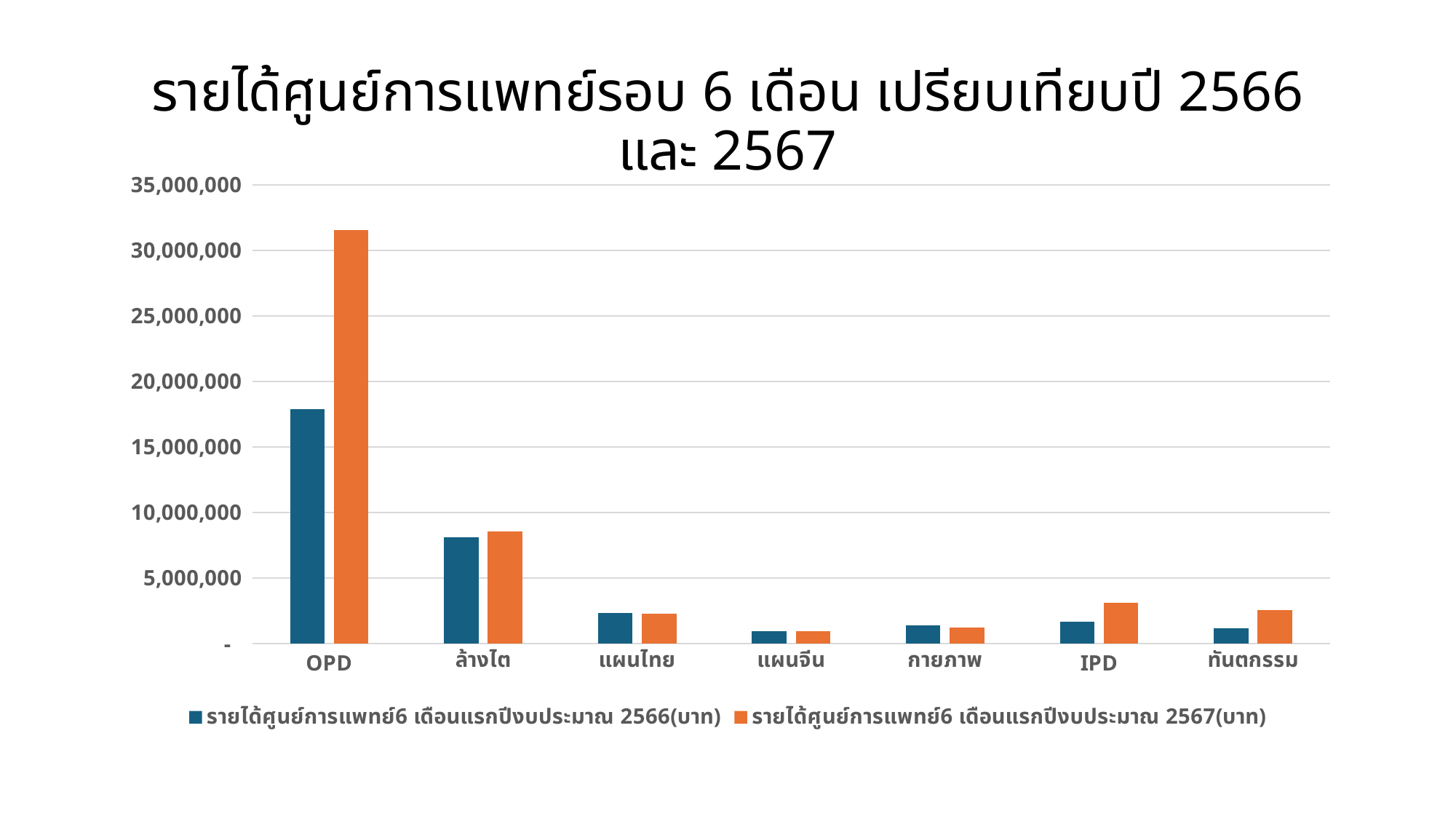
How many series does the legend list? 2 Which category has the highest value for the series รายได้ศูนย์การแพทย์6 เดือนแรกปีงบประมาณ 2566(บาท)? OPD Which category has the highest value for the series รายได้ศูนย์การแพทย์6 เดือนแรกปีงบประมาณ 2567(บาท)? OPD For ทันตกรรม, which series has the larger value: รายได้ศูนย์การแพทย์6 เดือนแรกปีงบประมาณ 2566(บาท) or รายได้ศูนย์การแพทย์6 เดือนแรกปีงบประมาณ 2567(บาท)? รายได้ศูนย์การแพทย์6 เดือนแรกปีงบประมาณ 2567(บาท) Is the value for OPD in the series รายได้ศูนย์การแพทย์6 เดือนแรกปีงบประมาณ 2567(บาท) greater or less than 30,000,000? greater Is the value for ล้างไต in the series รายได้ศูนย์การแพทย์6 เดือนแรกปีงบประมาณ 2566(บาท) greater or less than 10,000,000? less How many categories are shown on the x axis of the chart? 7 What colour represents the series รายได้ศูนย์การแพทย์6 เดือนแรกปีงบประมาณ 2567(บาท) in the chart? orange For OPD, which series has the larger value: รายได้ศูนย์การแพทย์6 เดือนแรกปีงบประมาณ 2566(บาท) or รายได้ศูนย์การแพทย์6 เดือนแรกปีงบประมาณ 2567(บาท)? รายได้ศูนย์การแพทย์6 เดือนแรกปีงบประมาณ 2567(บาท) Is the value for OPD in the series รายได้ศูนย์การแพทย์6 เดือนแรกปีงบประมาณ 2566(บาท) greater or less than 20,000,000? less For IPD, which series has the larger value: รายได้ศูนย์การแพทย์6 เดือนแรกปีงบประมาณ 2566(บาท) or รายได้ศูนย์การแพทย์6 เดือนแรกปีงบประมาณ 2567(บาท)? รายได้ศูนย์การแพทย์6 เดือนแรกปีงบประมาณ 2567(บาท) What kind of chart is shown on the slide? bar chart